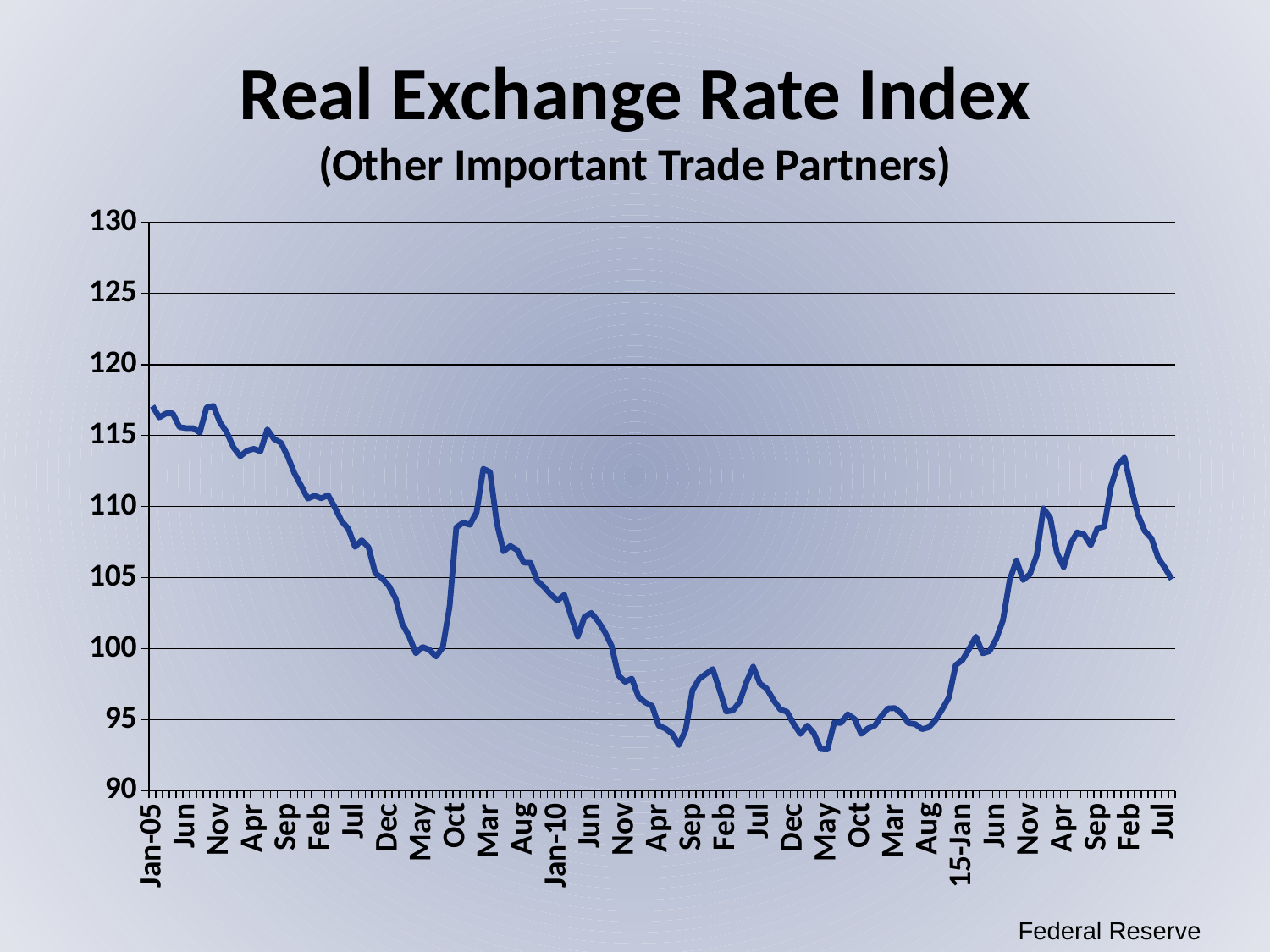
Is the value for 15-Jan greater or less than 105? less Is the value for Jan-10 greater or less than 100? greater What is the title of the chart? Real Exchange Rate Index (Other Important Trade Partners) Is the value at Jan-05 higher or lower than the value at the final point (Jul)? higher What is the highest value shown on the vertical axis? 130 Is the value at the final point (Jul) greater or less than 110? less Is the value for Jan-05 higher or lower than the value for Jan-10? higher Does the index rise or fall between Jan-05 and Jan-10? fall What source is cited for the chart? Federal Reserve What kind of chart is shown on the slide? line chart